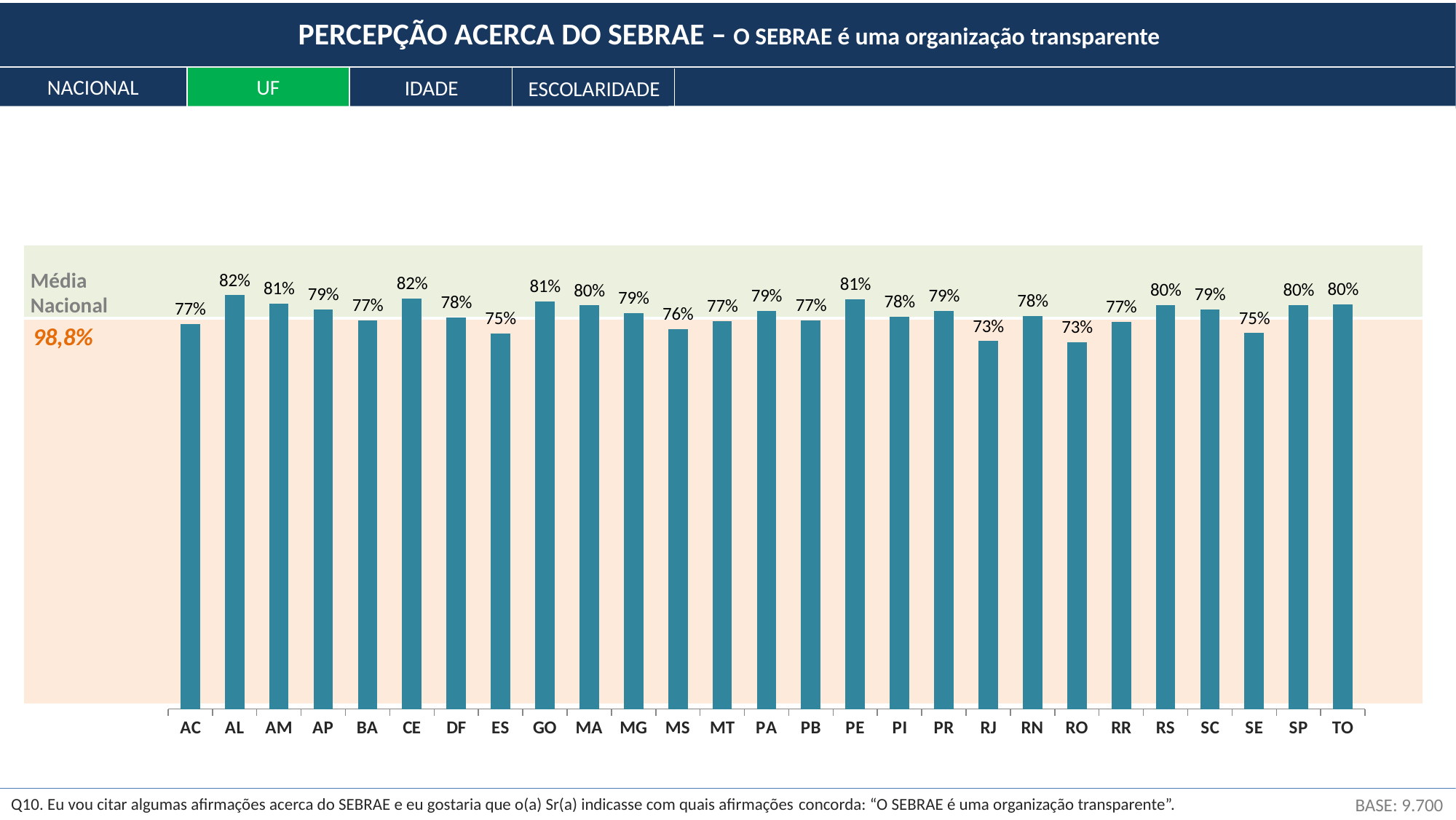
Which has a larger value, SE or PE? PE What value is given for the 'Média Nacional' on the chart? 98,8% What is the value for MS? 76% What kind of chart is shown on the slide? Bar chart What is the difference between the values for AL and RO? 9 percentage points What is the value for CE? 82% Which has a larger value, GO or ES? GO What is the highest value shown on the chart? 82% How many states (UF) are shown on the x axis? 27 What is the value for RJ? 73% What is the lowest value shown on the chart? 73% What is the value for SP? 80%